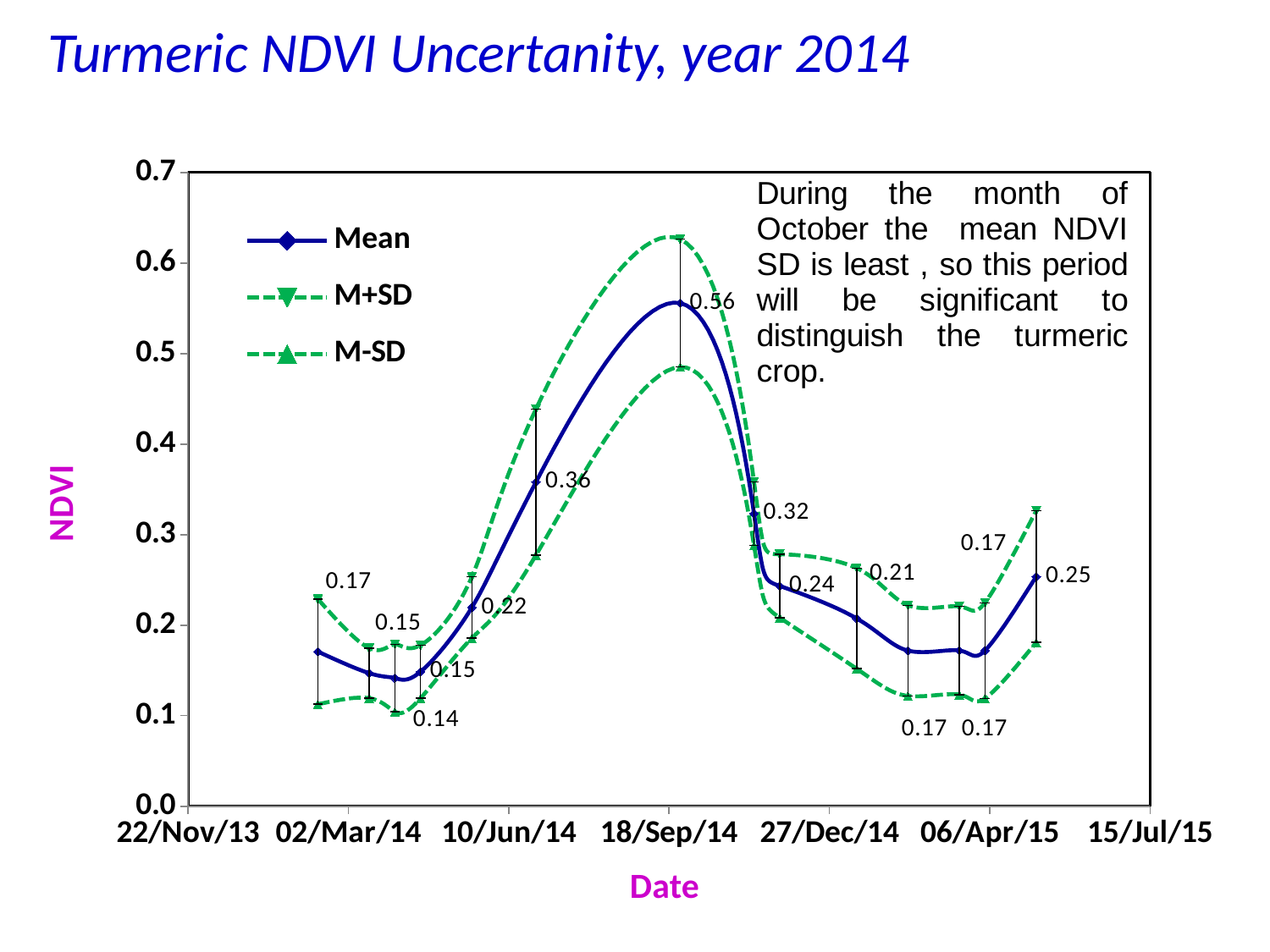
What is the difference between the highest and lowest labelled Mean values (0.56 and 0.14)? 0.42 What is the labelled Mean value at the last point on the right of the chart? 0.25 What type of chart is shown on the slide? line chart Does the Mean line rise or fall between 10/Jun/14 and 18/Sep/14? rise What is the lowest labelled value on the Mean line? 0.14 What is the title of the y axis? NDVI What is the highest labelled value on the Mean line? 0.56 Which labelled Mean value is larger, the 0.36 point before the peak or the 0.32 point after the peak? 0.36 What is the difference between the labelled Mean values 0.36 and 0.22? 0.14 Is the peak value of the M+SD line greater or less than 0.6? greater How many series does the legend list? 3 What are the three series named in the legend? Mean, M+SD, M-SD